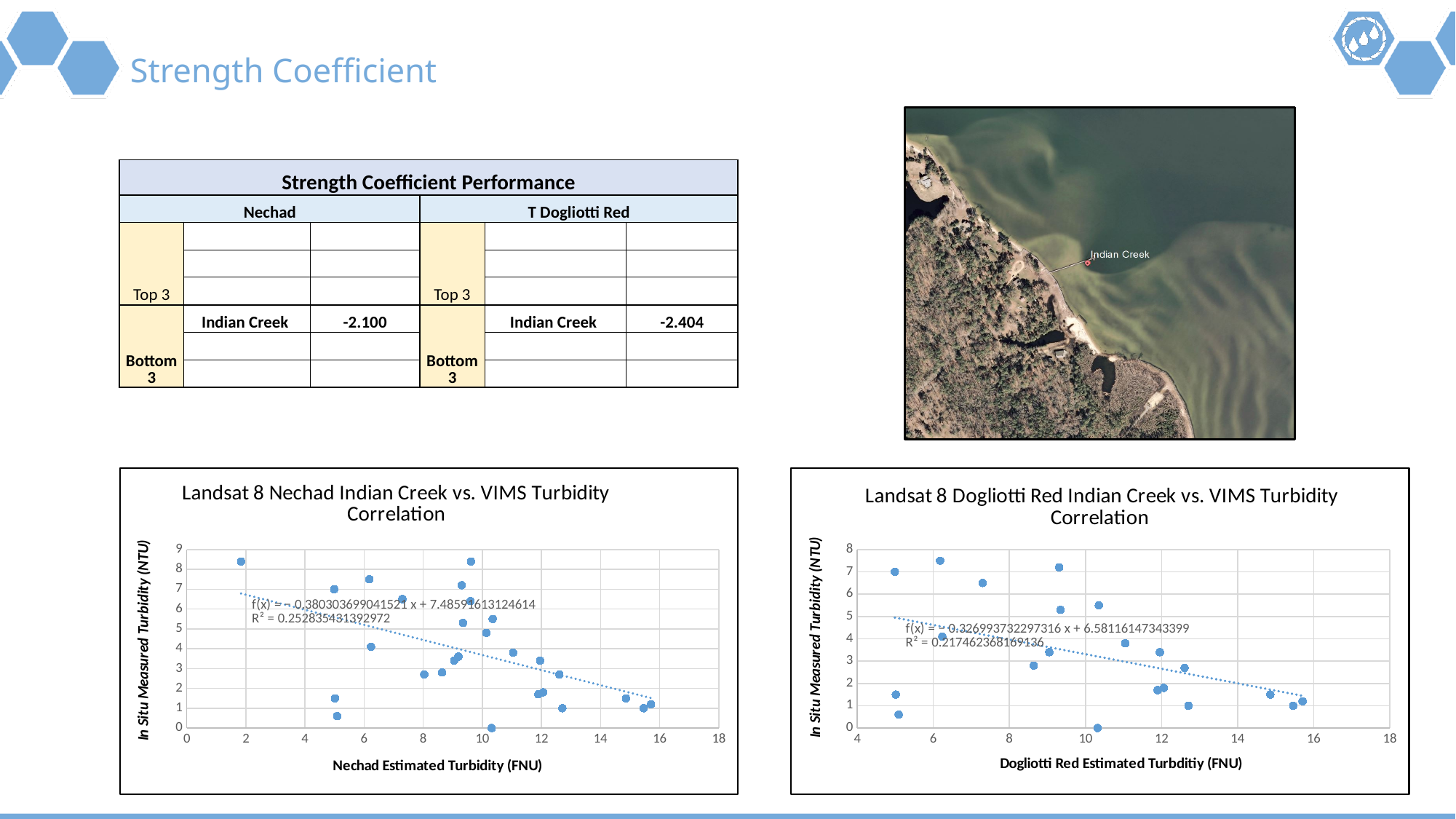
In the Nechad chart (bottom left), what is the R² value printed on the chart? R² = 0.252835431392972 In the Dogliotti Red chart (bottom right), what is the R² value printed on the chart? R² = 0.217462368169136 In the Nechad chart (bottom left), what is the trendline equation shown? f(x) = -0.380303699041521 x + 7.48591613124614 In the Nechad chart (bottom left), does the trendline rise or fall as estimated turbidity increases? Falls Which chart has the higher R² value, the Nechad chart or the Dogliotti Red chart? Nechad chart In the Nechad chart (bottom left), is the highest plotted point greater or less than 8 NTU? greater What kind of chart is the 'Landsat 8 Nechad Indian Creek vs. VIMS Turbidity Correlation' chart? Scatter chart In the Dogliotti Red chart (bottom right), what is the trendline equation shown? f(x) = -0.326993732297316 x + 6.58116147343399 In the Dogliotti Red chart (bottom right), is the highest plotted point greater or less than 7 NTU? greater In the Dogliotti Red chart (bottom right), does the trendline rise or fall along the x axis? Falls What kind of chart is the 'Landsat 8 Dogliotti Red Indian Creek vs. VIMS Turbidity Correlation' chart? Scatter chart What is the x-axis title of the Dogliotti Red chart (bottom right)? Dogliotti Red Estimated Turbditiy (FNU)